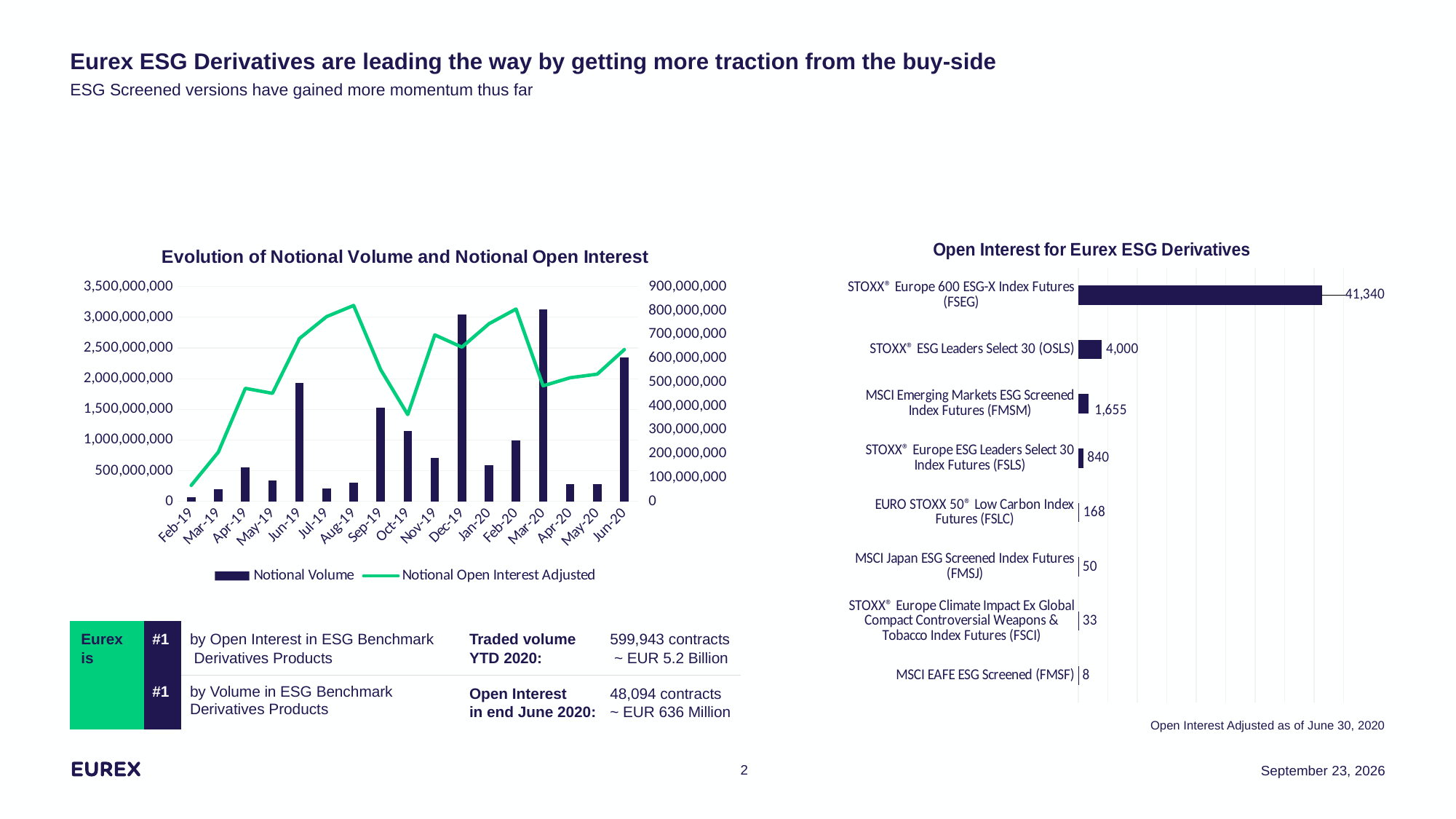
In the 'Open Interest for Eurex ESG Derivatives' chart, which product has the lowest open interest? MSCI EAFE ESG Screened (FMSF) In the 'Evolution of Notional Volume and Notional Open Interest' chart, is the Notional Volume for Mar-20 greater or less than 2,500,000,000? greater In the 'Evolution of Notional Volume and Notional Open Interest' chart, how many months are shown on the x axis? 17 In the 'Open Interest for Eurex ESG Derivatives' chart, what is the difference between the values for STOXX ESG Leaders Select 30 (OSLS) and STOXX Europe ESG Leaders Select 30 Index Futures (FSLS)? 3,160 What kind of chart is the 'Open Interest for Eurex ESG Derivatives' chart? Bar chart In the 'Open Interest for Eurex ESG Derivatives' chart, what is the open interest for STOXX Europe 600 ESG-X Index Futures (FSEG)? 41,340 In the 'Open Interest for Eurex ESG Derivatives' chart, what is the value for MSCI Emerging Markets ESG Screened Index Futures (FMSM)? 1,655 How many series does the legend of the 'Evolution of Notional Volume and Notional Open Interest' chart list? 2 How many products are shown in the 'Open Interest for Eurex ESG Derivatives' chart? 8 In the 'Open Interest for Eurex ESG Derivatives' chart, which is larger: the value for EURO STOXX 50 Low Carbon Index Futures (FSLC) or MSCI Japan ESG Screened Index Futures (FMSJ)? EURO STOXX 50 Low Carbon Index Futures (FSLC) In the 'Evolution of Notional Volume and Notional Open Interest' chart, is the Notional Volume for Jun-19 greater or less than 2,000,000,000? less In the 'Evolution of Notional Volume and Notional Open Interest' chart, which month has the lowest Notional Volume bar? Feb-19